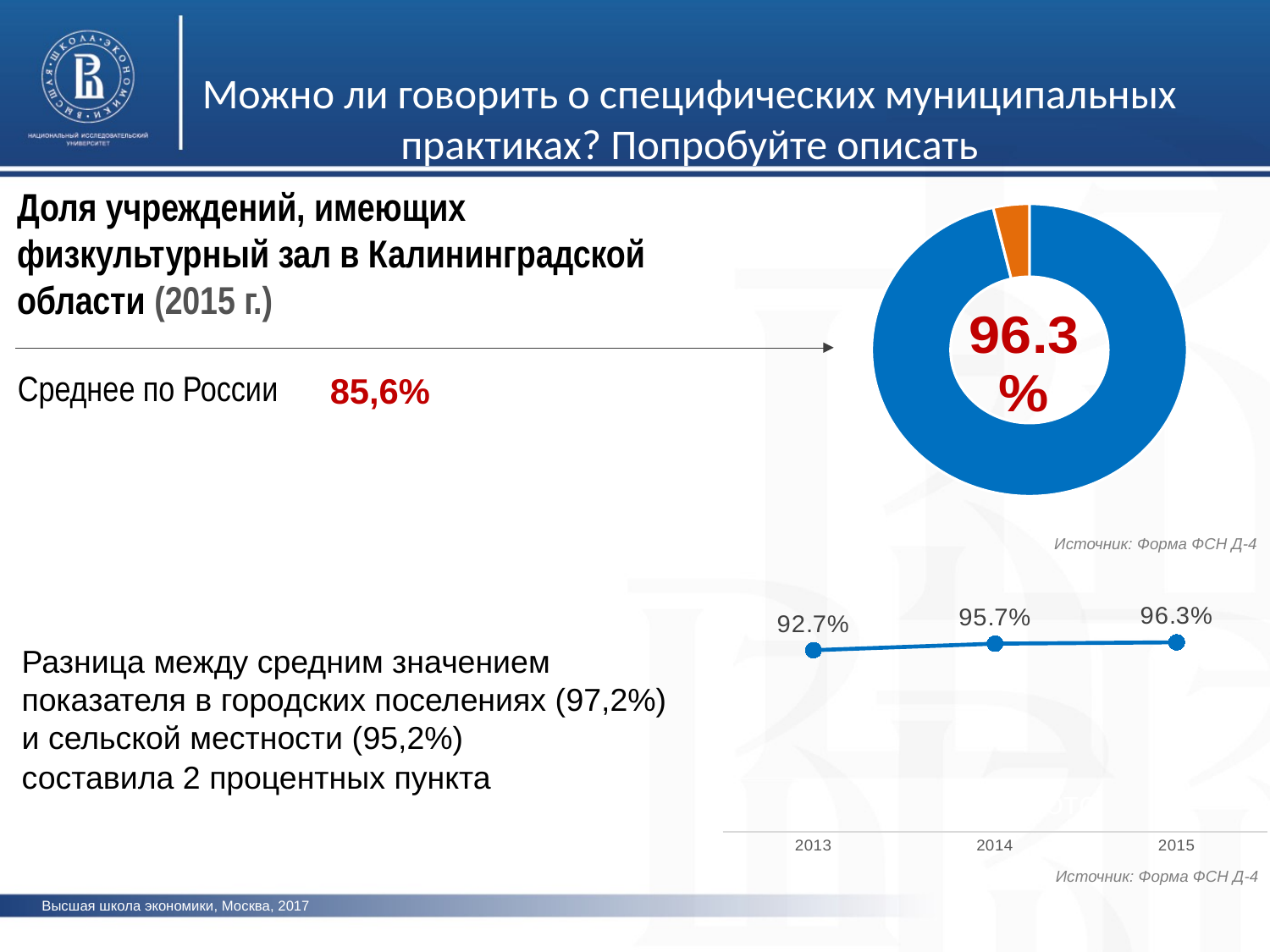
In the line chart at the bottom right, which year has the lowest value? 2013 In the line chart at the bottom right, what is the value for 2015? 96.3% In the line chart at the bottom right, which year has the highest value? 2015 In the line chart at the bottom right, what is the value for 2013? 92.7% In the line chart at the bottom right, what is the value for 2014? 95.7% In the line chart at the bottom right, is the value for 2014 larger or smaller than the value for 2013? Larger What kind of chart is shown in the top right of the slide? Donut (pie) chart What kind of chart is shown in the bottom right of the slide? Line chart In the line chart at the bottom right, how many years are plotted? 3 In the donut chart at the top right, what value is printed in the centre? 96.3% In the line chart at the bottom right, do the values rise or fall from 2013 to 2015? Rise In the line chart at the bottom right, what is the difference between the 2015 and 2013 values? 3.6 percentage points